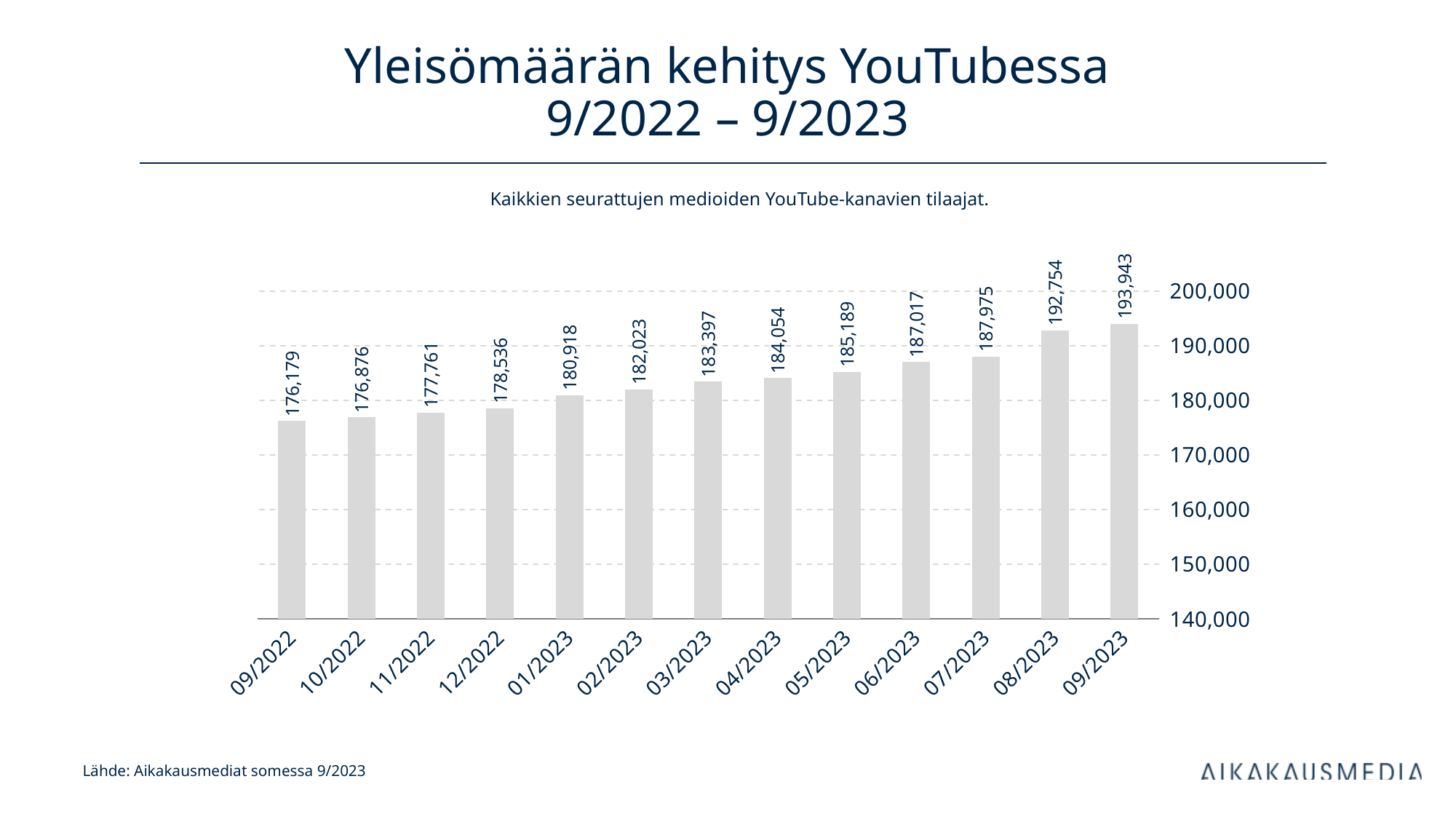
Is the value for 06/2023 greater or less than 190,000? less What is the difference between the values for 09/2023 and 09/2022? 17,764 Which month has the lowest value? 09/2022 What is the value for 09/2023? 193,943 What is the difference between the values for 08/2023 and 07/2023? 4,779 What is the value for 03/2023? 183,397 What kind of chart is shown on the slide? bar chart How many months are shown on the x axis? 13 Do the values rise or fall from 09/2022 to 09/2023? rise Which month has the highest value? 09/2023 Which is larger, the value for 01/2023 or the value for 12/2022? 01/2023 What is the value for 09/2022? 176,179